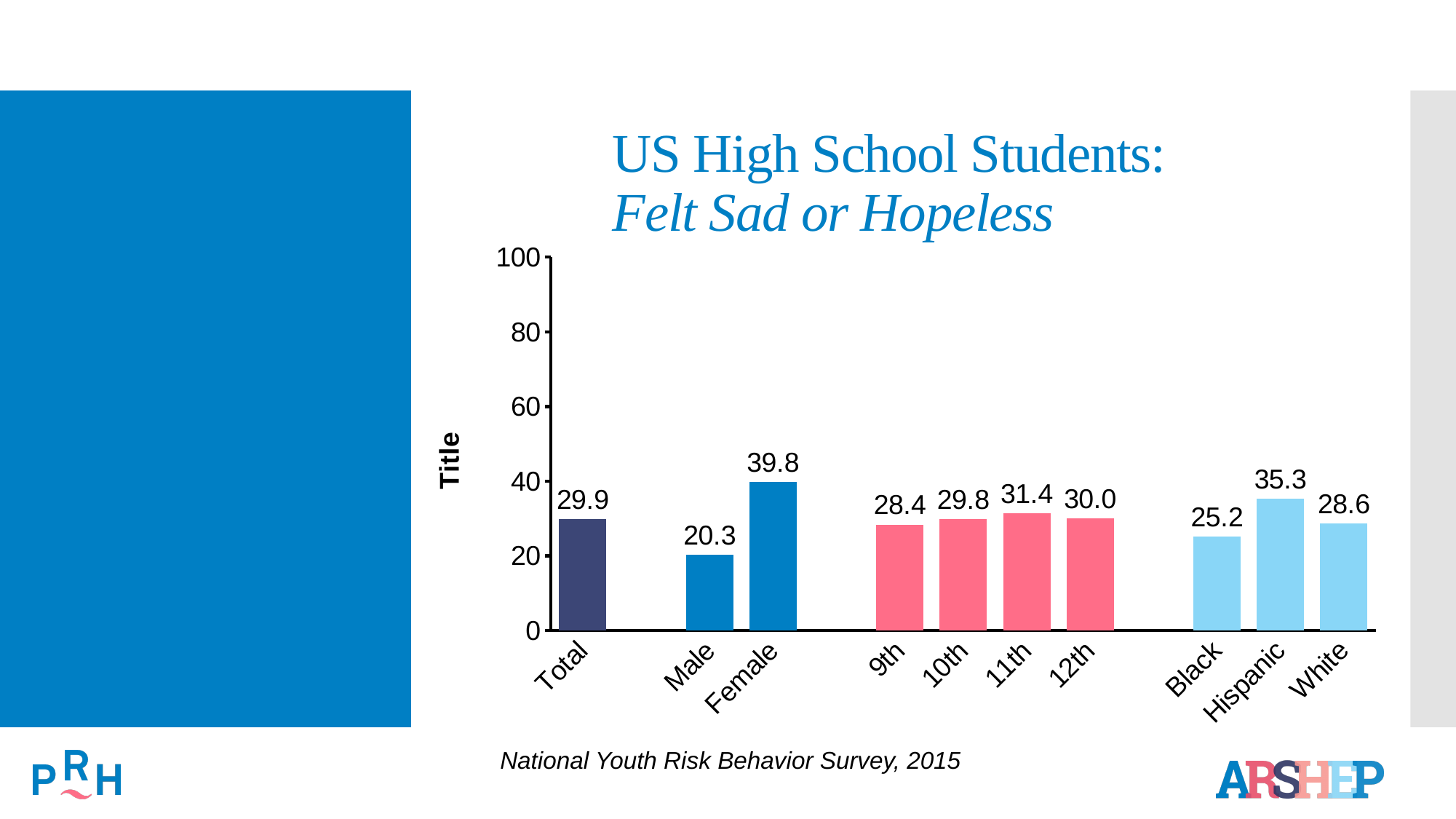
What is the title of the chart? US High School Students: Felt Sad or Hopeless What is the value for Hispanic? 35.3 What is the value for 11th? 31.4 What is the value for Female? 39.8 What is the difference between the Hispanic and Black values? 10.1 What is the value for Total? 29.9 Which is larger, the value for 9th or the value for 12th? 12th What is the difference between the Female and Male values? 19.5 How many categories are shown on the x axis? 10 What kind of chart is this? Bar chart Which category has the highest value? Female Which category has the lowest value? Male